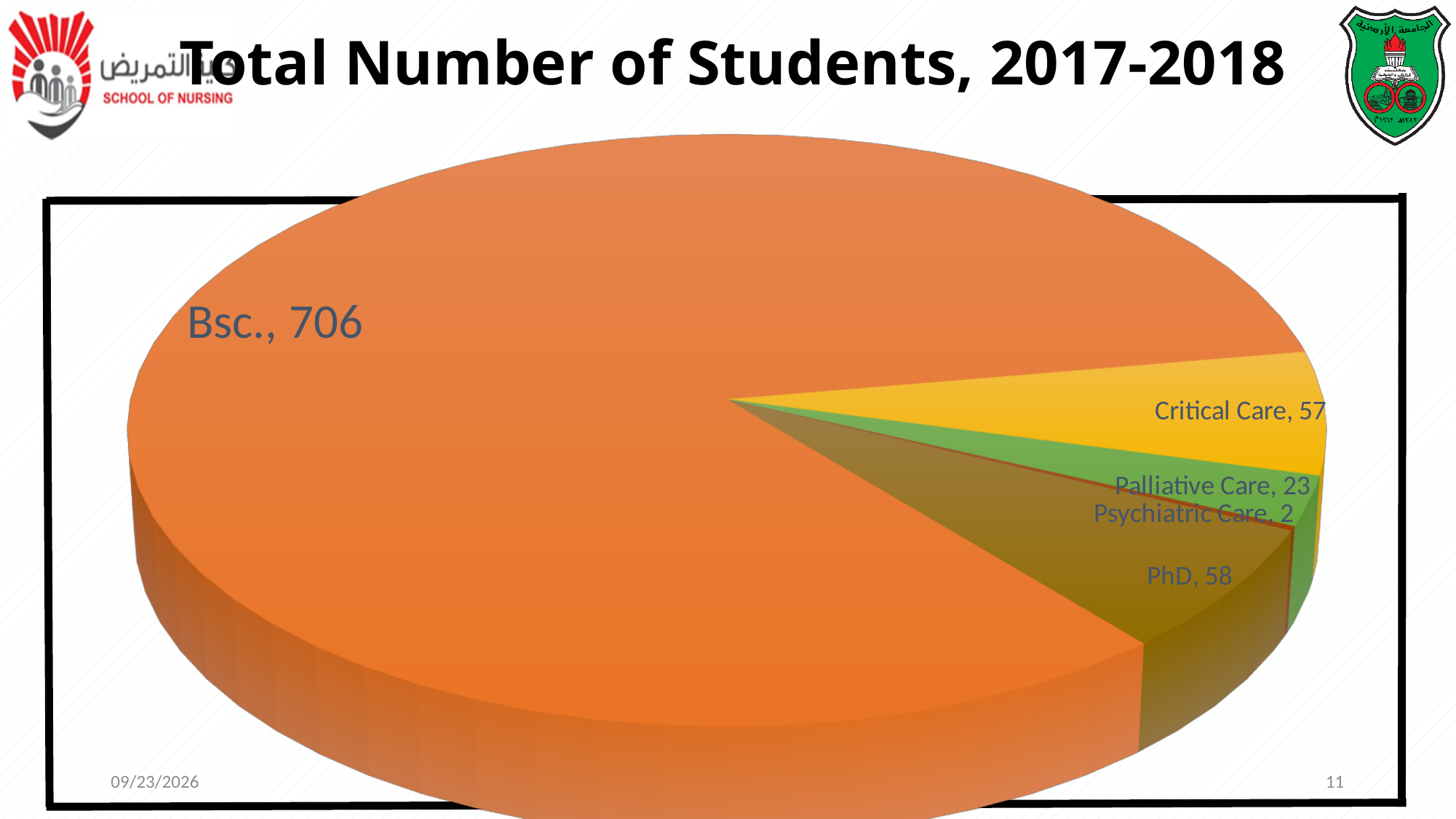
What is the value shown for Psychiatric Care? 2 What kind of chart is shown on the slide? Pie chart What is the difference between the Critical Care and Palliative Care values? 34 Which category has the smallest slice of the pie? Psychiatric Care Which category has the largest slice of the pie? Bsc. Which has more students, PhD or Critical Care? PhD What is the value shown for Critical Care? 57 What is the value shown for PhD? 58 What is the value shown for Palliative Care? 23 How many categories are shown in the pie chart? 5 What is the title of the chart on the slide? Total Number of Students, 2017-2018 How many students are in the Bsc. slice of the pie chart? 706